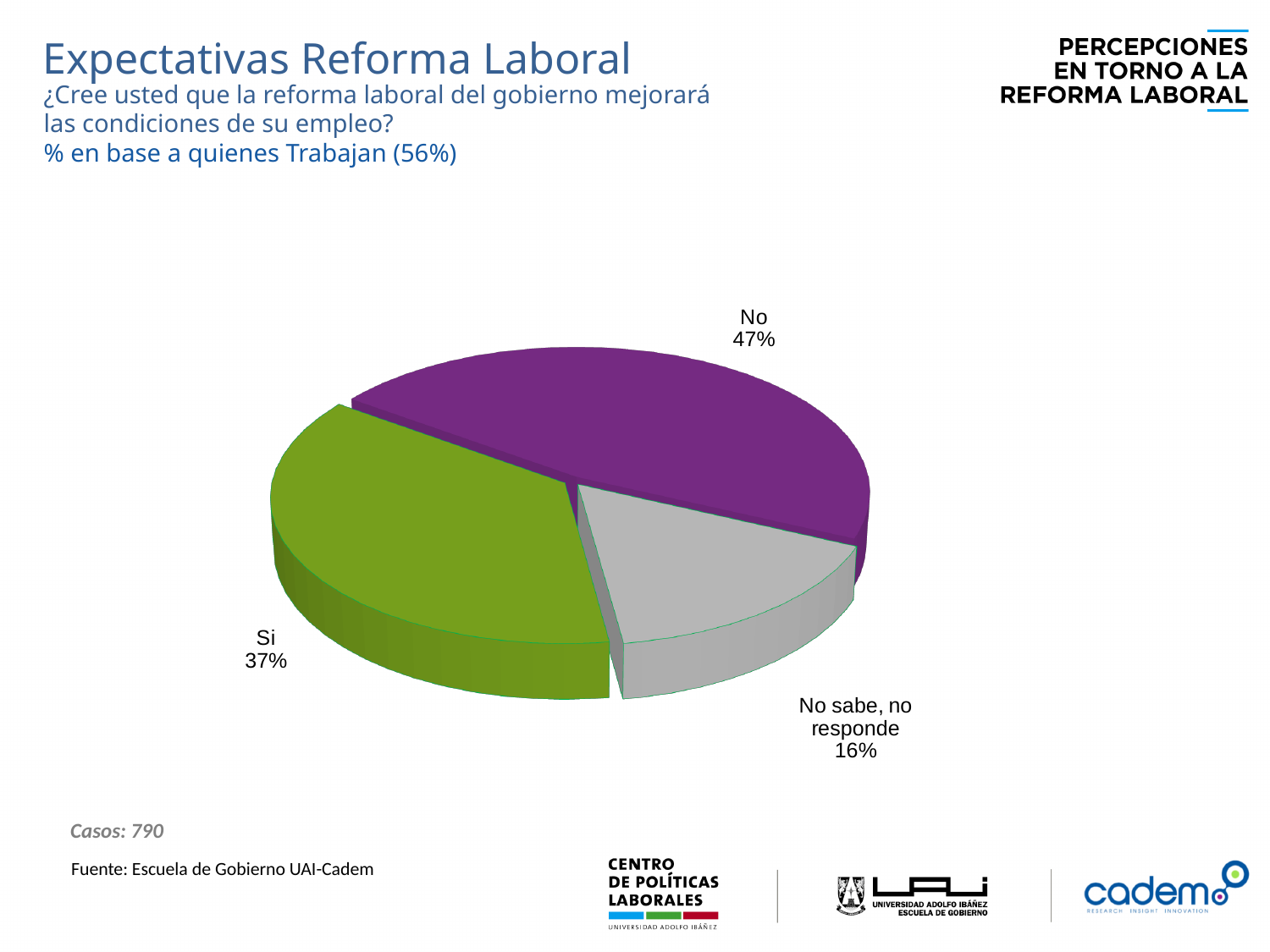
What is the difference in percentage points between the "Si" and "No sabe, no responde" slices? 21 What percentage of respondents answered "No sabe, no responde"? 16% How many slices does the pie chart have? 3 Which response has the largest share of the pie? No What colour is the "Si" slice of the pie? Green How many cases (Casos) does the slide report for this chart? 790 What kind of chart is shown on the slide? Pie chart Which is larger, the "Si" slice or the "No sabe, no responde" slice? Si Which response has the smallest share of the pie? No sabe, no responde What percentage of respondents answered "No"? 47% What is the difference in percentage points between the "No" and "Si" slices? 10 What percentage of respondents answered "Si"? 37%